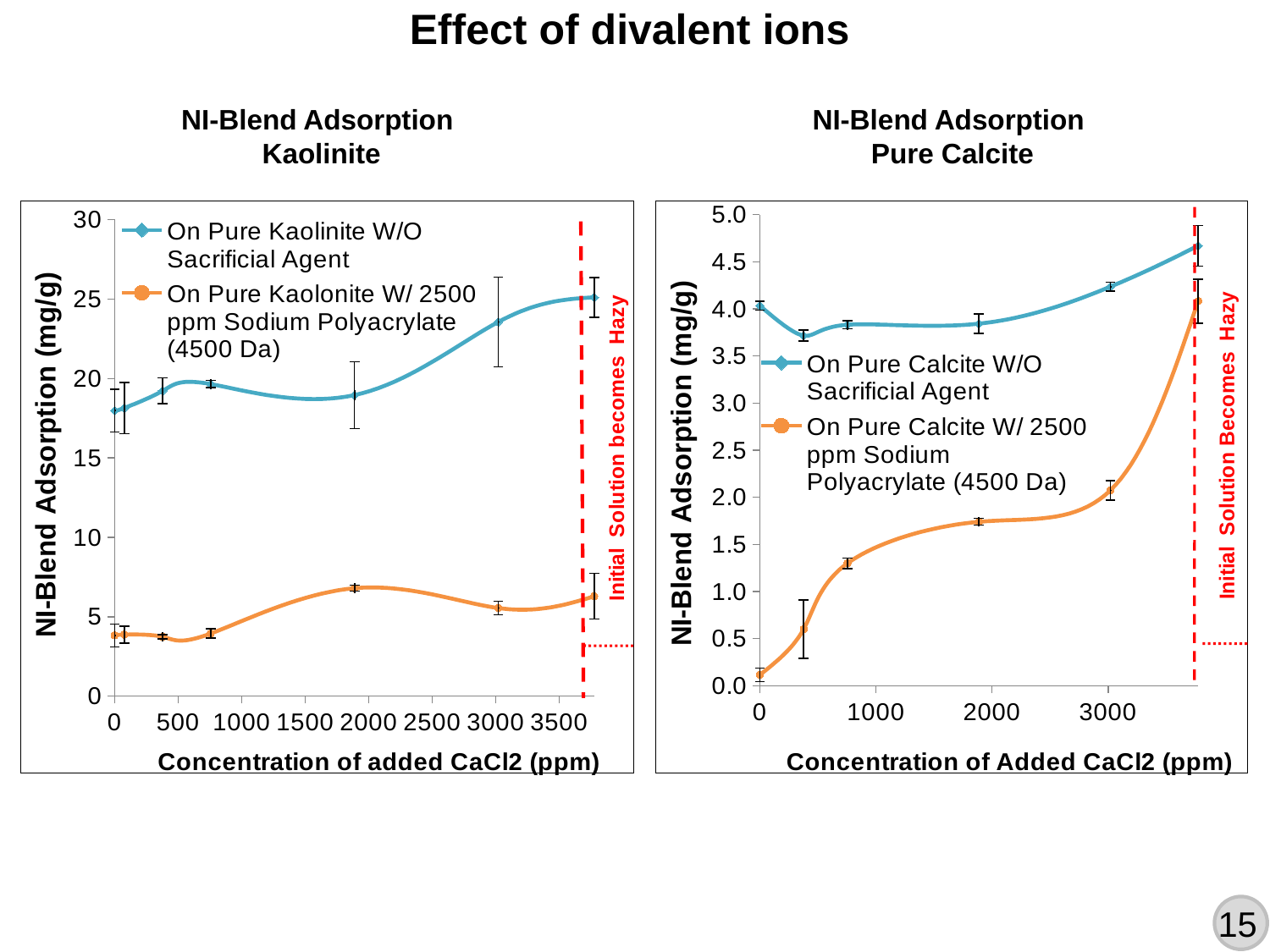
What kind of chart is the 'NI-Blend Adsorption Kaolinite' chart on the left? line chart What does the red dashed vertical line in the 'NI-Blend Adsorption Pure Calcite' chart mark, according to its label? Initial Solution Becomes Hazy In the 'NI-Blend Adsorption Pure Calcite' chart, is the value for 'On Pure Calcite W/ 2500 ppm Sodium Polyacrylate (4500 Da)' at 0 ppm greater or less than 0.5? less In the 'NI-Blend Adsorption Pure Calcite' chart, is the value for 'On Pure Calcite W/O Sacrificial Agent' at 0 ppm greater or less than 3.5? greater In the 'NI-Blend Adsorption Pure Calcite' chart, is the value for 'On Pure Calcite W/ 2500 ppm Sodium Polyacrylate (4500 Da)' at 3000 ppm greater or less than 1.5? greater How many series does the legend of the 'NI-Blend Adsorption Pure Calcite' chart list? 2 How many series does the legend of the 'NI-Blend Adsorption Kaolinite' chart list? 2 In the 'NI-Blend Adsorption Pure Calcite' chart, does the 'On Pure Calcite W/ 2500 ppm Sodium Polyacrylate (4500 Da)' series rise or fall as CaCl2 concentration increases? rise In the 'NI-Blend Adsorption Kaolinite' chart, which series has the higher adsorption at 0 ppm CaCl2? On Pure Kaolinite W/O Sacrificial Agent